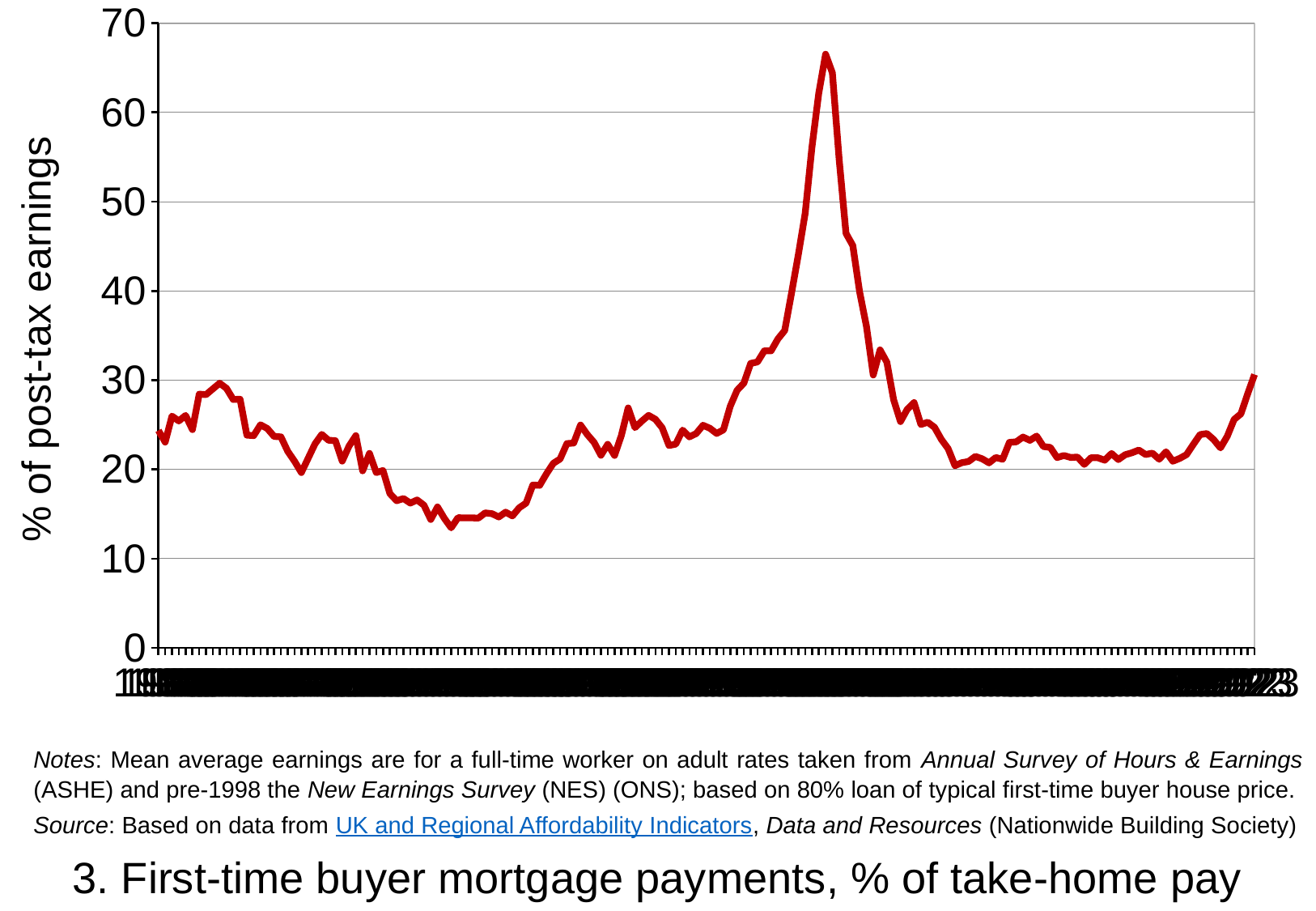
Is the lowest point of the line greater or less than 20? less What is the highest value shown on the vertical axis? 70 Is the value at the start of the line (left end) greater or less than 20? greater What is the title of the chart? 3. First-time buyer mortgage payments, % of take-home pay Which is larger: the peak value of the line or the value at the right end of the line? the peak value Is the value at the right end of the line greater or less than 20? greater How many lines (series) are plotted on the chart? 1 What kind of chart is shown on the slide? line chart What is the label on the vertical axis of the chart? % of post-tax earnings